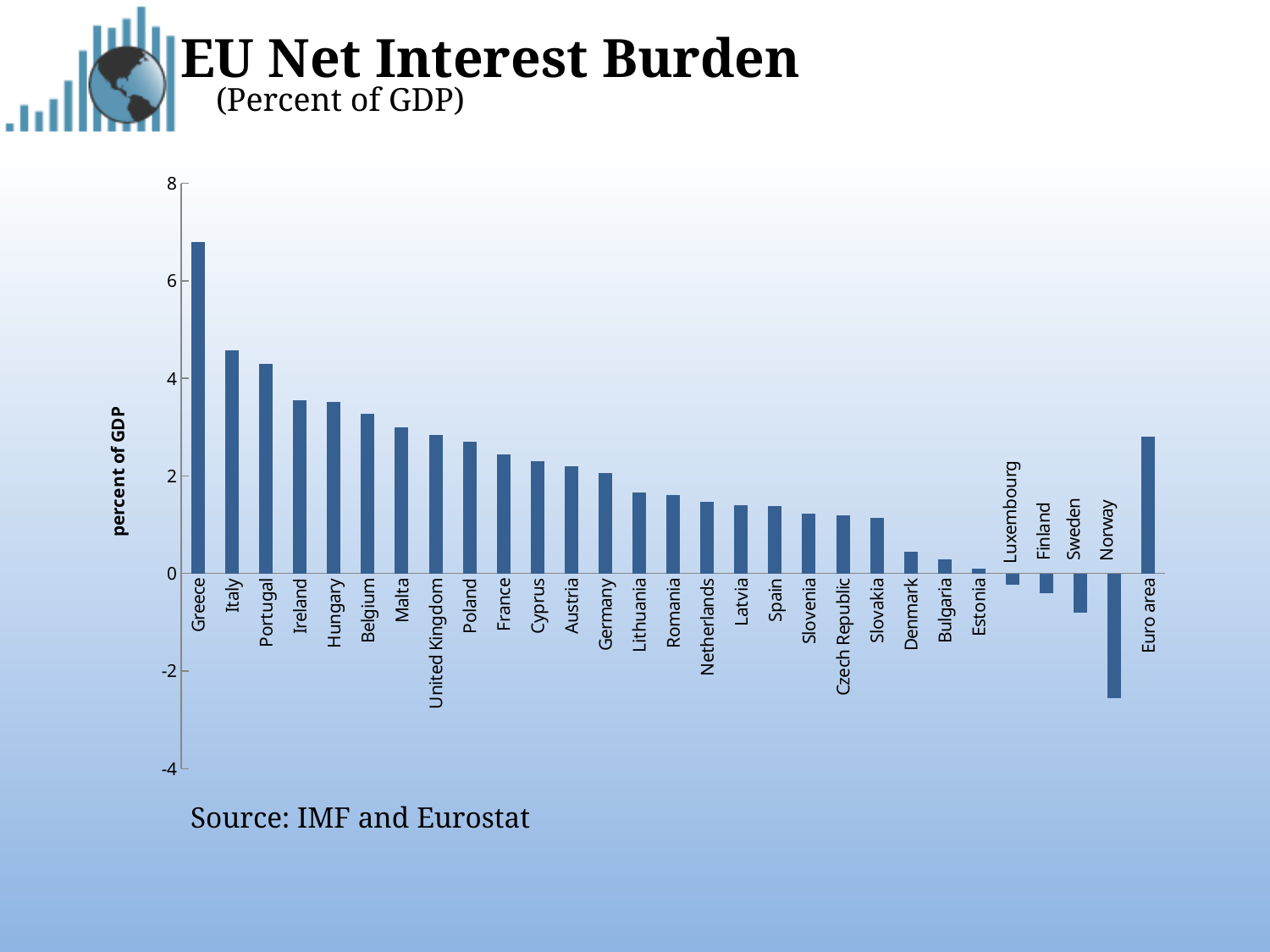
Is the value for Norway greater or less than -2? less Is the value for Euro area greater or less than 2? greater Which country has the highest net interest burden in the chart? Greece Which has a larger net interest burden, Spain or Sweden? Spain What kind of chart is shown on the slide? bar chart Is the value for Greece greater or less than 6? greater What is the label on the vertical axis of the chart? percent of GDP Which country has the lowest net interest burden in the chart? Norway Which has a larger net interest burden, Portugal or Belgium? Portugal How many bars are plotted in the chart? 29